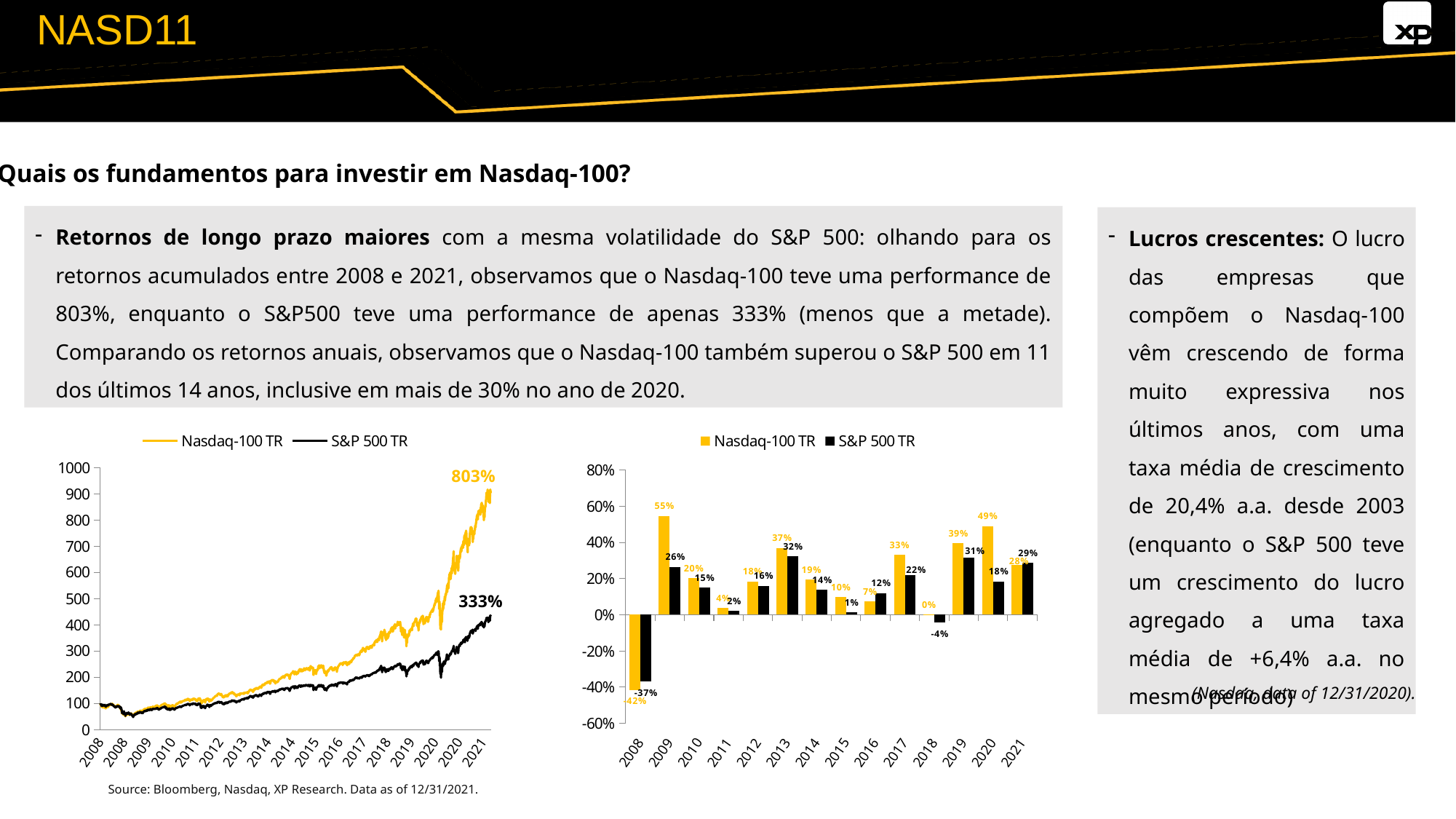
In the bar chart on the right, what is the difference between the Nasdaq-100 TR and S&P 500 TR returns in 2020? 31% In the bar chart on the right, what was the S&P 500 TR annual return in 2008? -37% In the bar chart on the right, which year had the lowest S&P 500 TR annual return? 2008 In the bar chart on the right, what was the Nasdaq-100 TR annual return in 2020? 49% In the line chart on the left, is the final value of the S&P 500 TR line greater or less than 500? less In the bar chart on the right, how many years are shown on the x axis? 14 What kind of chart is the chart on the left of the slide? Line chart In the line chart on the left, what cumulative return value is labelled at the end of the Nasdaq-100 TR line? 803% In the bar chart on the right, how many series does the legend list? 2 In the line chart on the left, which colour represents the Nasdaq-100 TR series? Yellow In the bar chart on the right, which year had the highest Nasdaq-100 TR annual return? 2009 In the bar chart on the right, which series had the larger return in 2016, Nasdaq-100 TR or S&P 500 TR? S&P 500 TR